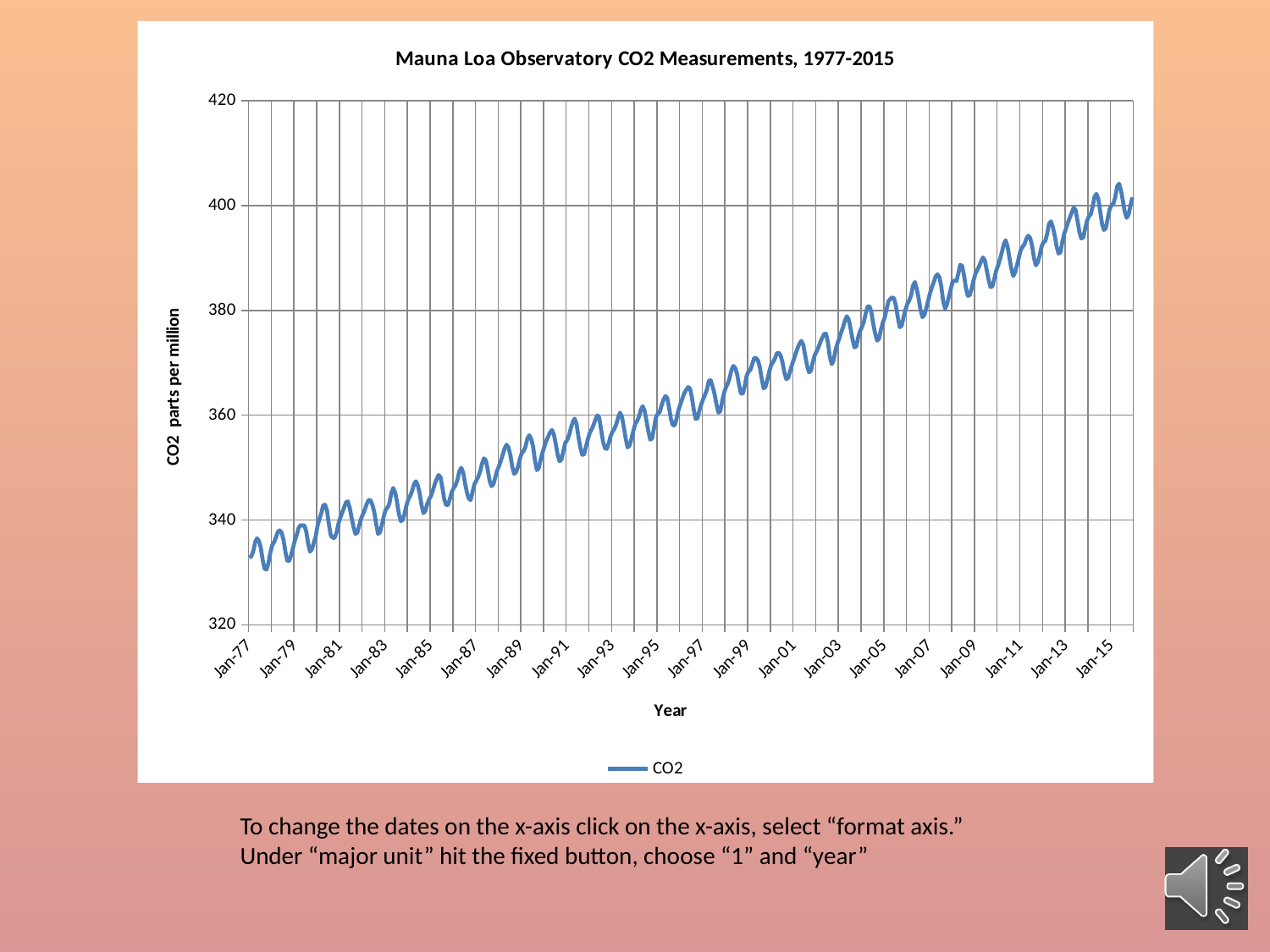
Is the CO2 value at Jan-13 greater or less than 380? greater How many year labels are shown along the x-axis? 20 Which is larger, the CO2 value at Jan-15 or at Jan-77? Jan-15 Is the CO2 value at Jan-77 greater or less than 340? less Is the CO2 value at Jan-15 greater or less than 380? greater How many series does the legend list? 1 What is the title of the chart? Mauna Loa Observatory CO2 Measurements, 1977-2015 Do the CO2 values generally rise or fall from Jan-77 to Jan-15? rise What kind of chart is shown on the slide? line chart What is the label on the y-axis? CO2 parts per million